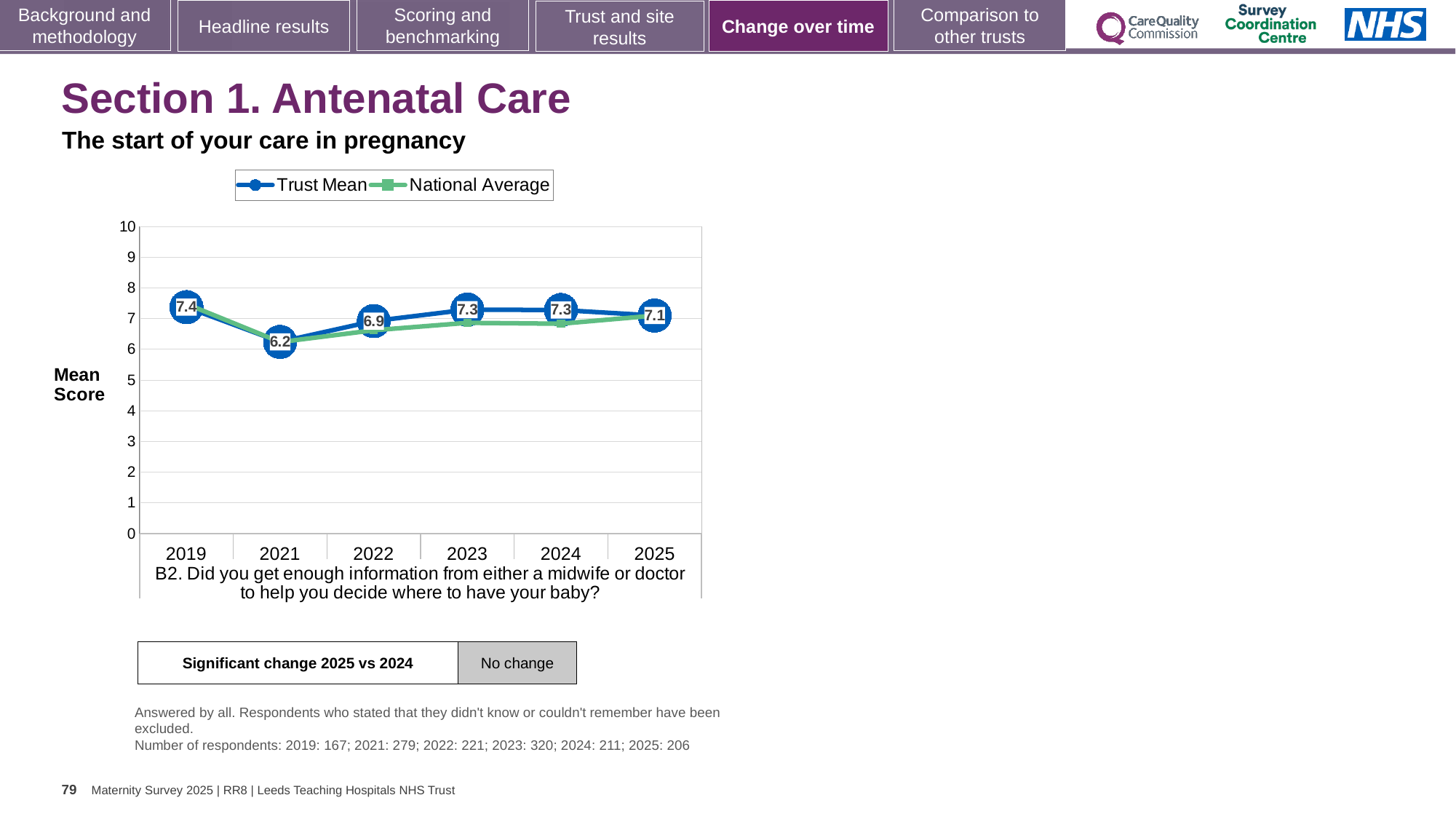
What kind of chart is shown? line chart In which year is the Trust Mean highest? 2019 Does the Trust Mean rise or fall from 2019 to 2021? fall What is the Trust Mean value for 2021? 6.2 Is the National Average value for 2021 greater or less than 7? less What is the difference between the Trust Mean in 2019 and in 2021? 1.2 In which year is the Trust Mean lowest? 2021 How many series does the legend list? 2 What is the Trust Mean value for 2019? 7.4 Which is larger, the Trust Mean in 2022 or in 2023? 2023 How many years are plotted on the x axis? 6 What is the Trust Mean value for 2025? 7.1